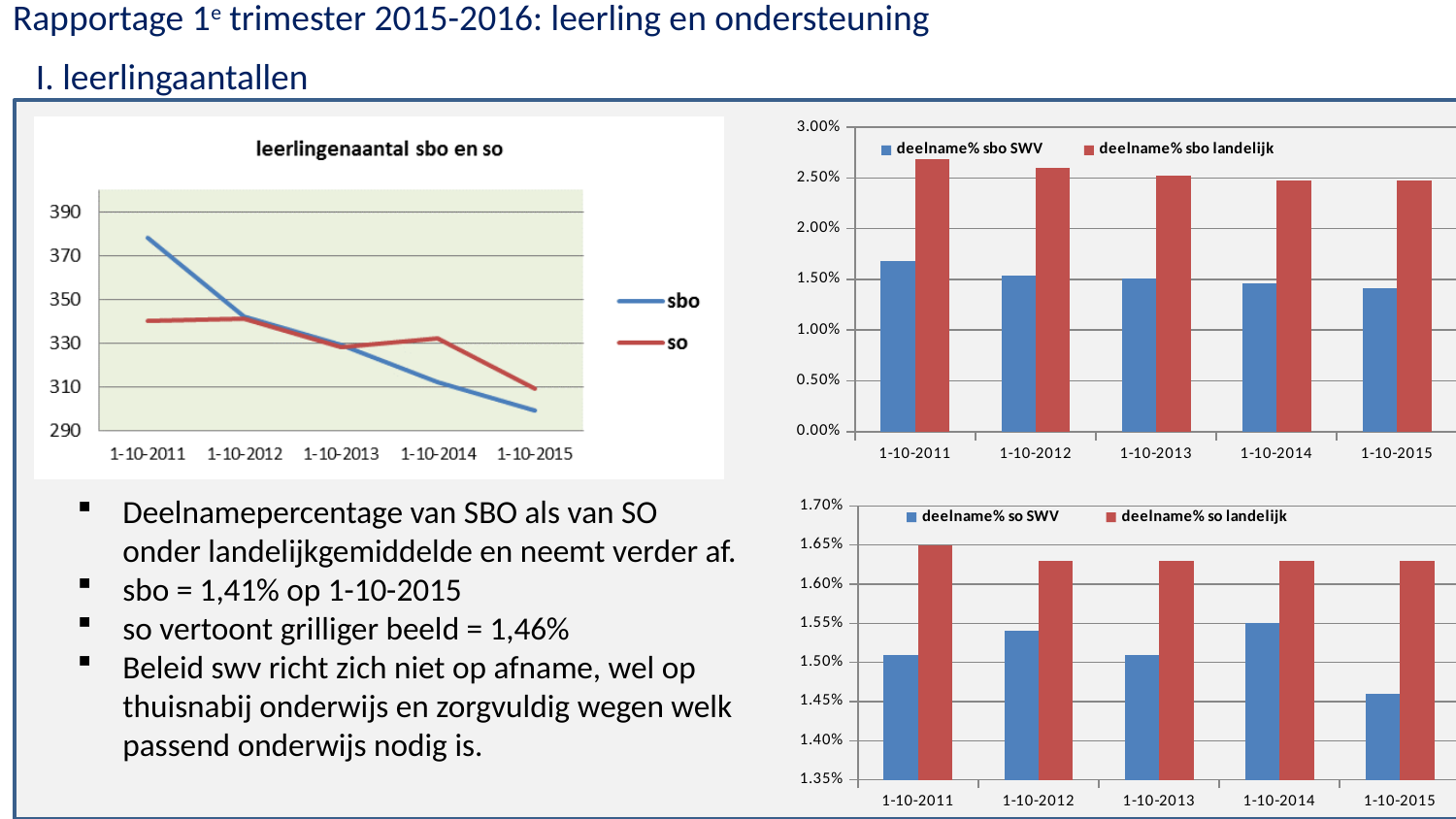
In the 'leerlingenaantal sbo en so' chart, is the sbo value at 1-10-2011 greater or less than 370? greater What kind of chart is the 'leerlingenaantal sbo en so' chart on the left? line chart In the top-right chart (deelname% sbo), is the deelname% sbo landelijk value at 1-10-2011 greater or less than 2.50%? greater In the 'leerlingenaantal sbo en so' chart, is the so value at 1-10-2015 greater or less than 330? less In the top-right chart (deelname% sbo), at which date is deelname% sbo SWV highest? 1-10-2011 In the 'leerlingenaantal sbo en so' chart, which series has the higher value at 1-10-2011, sbo or so? sbo How many series does the legend of the 'leerlingenaantal sbo en so' chart list? 2 In the 'leerlingenaantal sbo en so' chart, does the sbo line rise or fall from 1-10-2011 to 1-10-2015? fall In the bottom-right chart (deelname% so), at which date is deelname% so SWV lowest? 1-10-2015 How many dates are shown on the x axis of the 'leerlingenaantal sbo en so' chart? 5 What kind of chart is the top-right chart showing deelname% sbo SWV and deelname% sbo landelijk? bar chart